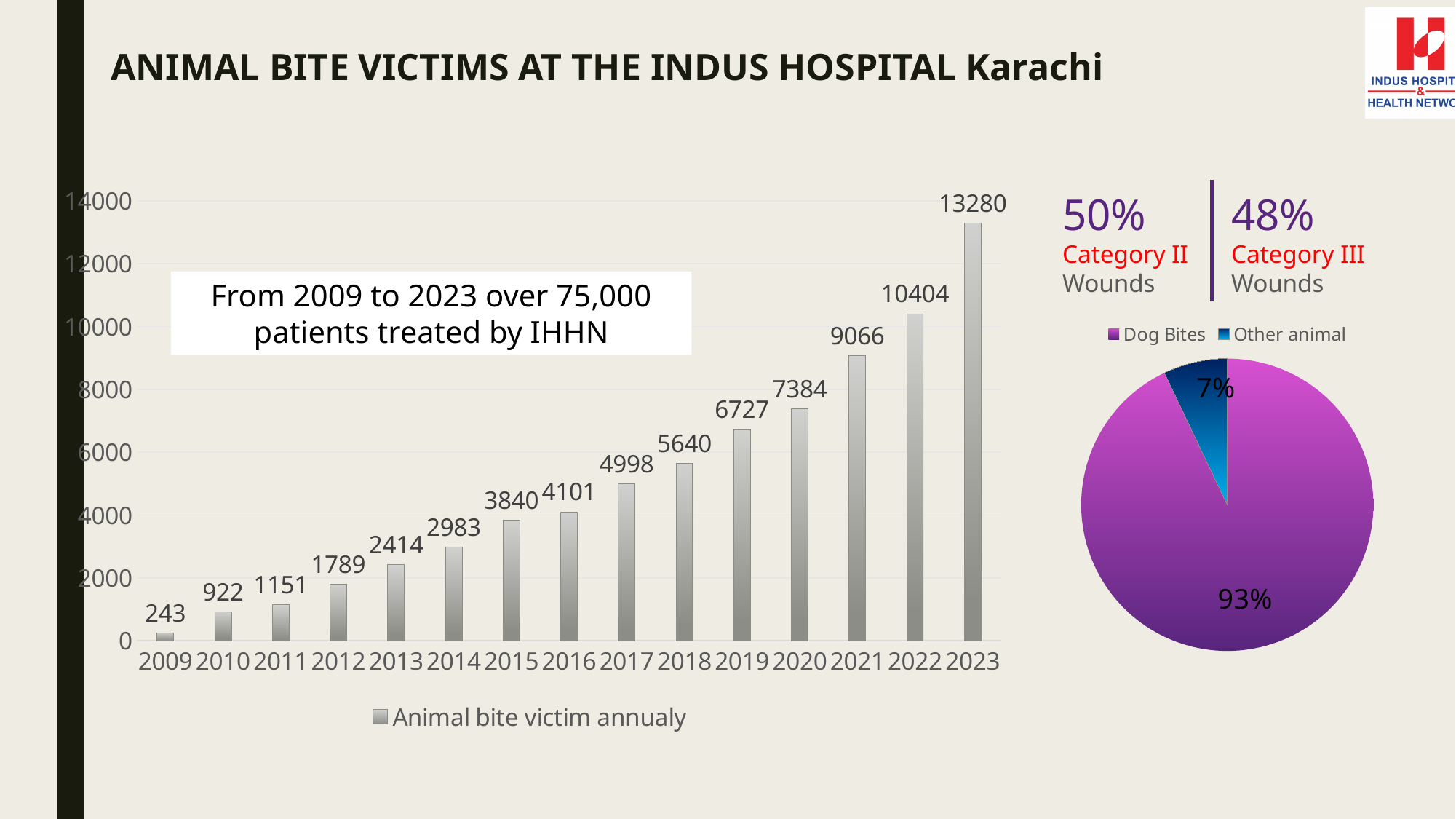
In the bar chart on the left, what is the value for 2016? 4101 In the pie chart on the right, how many series does the legend list? 2 In the bar chart on the left, which year has the lowest value? 2009 In the bar chart on the left, do the values rise or fall from 2009 to 2023? rise In the pie chart on the right, what share is Dog Bites? 93% In the bar chart on the left, which is larger, the value for 2014 or the value for 2015? 2015 What kind of chart is the chart on the left of the slide? bar chart In the bar chart on the left, what is the value for 2023? 13280 In the bar chart on the left, how many years are shown on the x axis? 15 In the bar chart on the left, what is the difference between the values for 2022 and 2021? 1338 In the bar chart on the left, what is the value for 2009? 243 In the bar chart on the left, which year has the highest value? 2023